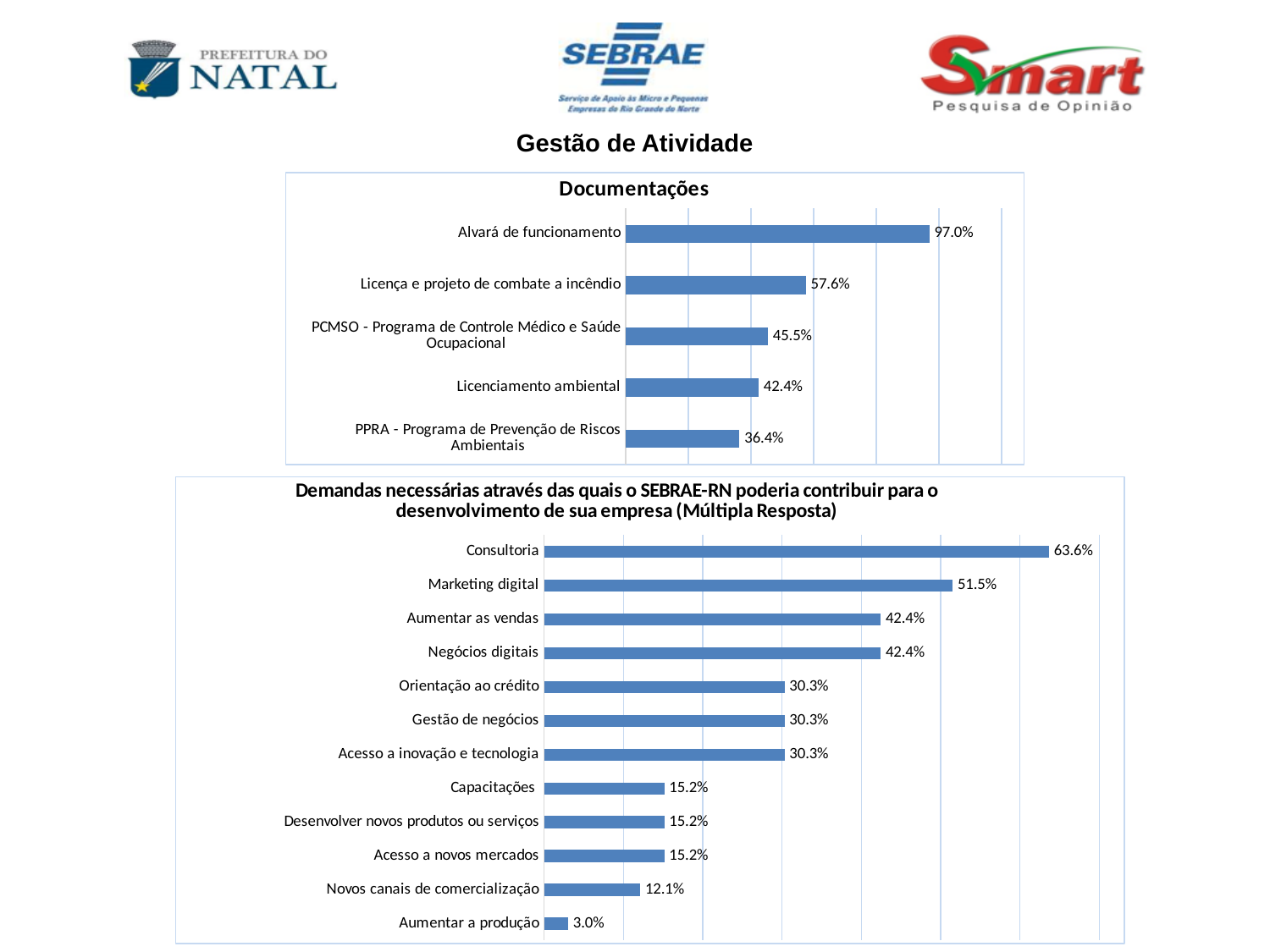
In the bottom chart (Demandas necessárias...), which category has the highest value? Consultoria In the bottom chart (Demandas necessárias...), which is larger: Orientação ao crédito or Capacitações? Orientação ao crédito In the 'Documentações' chart, what is the value for Alvará de funcionamento? 97.0% In the 'Documentações' chart, what is the value for Licenciamento ambiental? 42.4% In the 'Documentações' chart, what is the difference between Alvará de funcionamento and Licença e projeto de combate a incêndio? 39.4% In the bottom chart (Demandas necessárias...), what is the value for Marketing digital? 51.5% What type of chart is the 'Documentações' chart? Bar chart In the bottom chart (Demandas necessárias...), which category has the lowest value? Aumentar a produção In the 'Documentações' chart, how many categories are shown? 5 In the bottom chart (Demandas necessárias...), how many categories are shown? 12 In the 'Documentações' chart, which category has the lowest value? PPRA - Programa de Prevenção de Riscos Ambientais In the bottom chart (Demandas necessárias...), what is the difference between Consultoria and Novos canais de comercialização? 51.5%